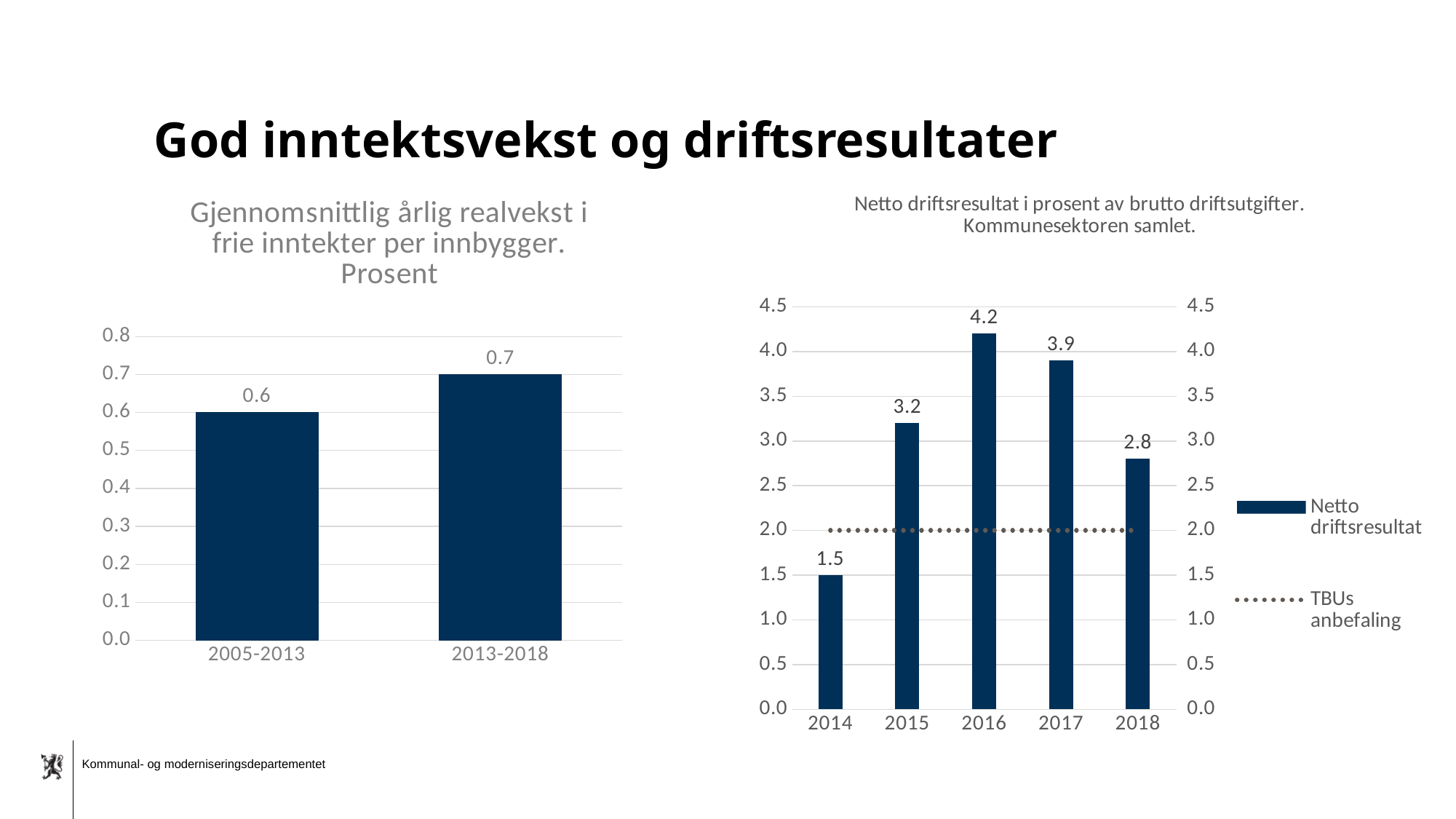
In the right chart (Netto driftsresultat i prosent av brutto driftsutgifter), what is the difference between the 2017 and 2018 values? 1.1 In the left chart (Gjennomsnittlig årlig realvekst i frie inntekter per innbygger), how many categories are shown? 2 In the right chart (Netto driftsresultat i prosent av brutto driftsutgifter), which is larger, the value for 2015 or the value for 2018? 2015 In the right chart (Netto driftsresultat i prosent av brutto driftsutgifter), which year has the highest Netto driftsresultat? 2016 In the right chart (Netto driftsresultat i prosent av brutto driftsutgifter), which year has the lowest Netto driftsresultat? 2014 In the right chart (Netto driftsresultat i prosent av brutto driftsutgifter), how many entries does the legend list? 2 In the right chart (Netto driftsresultat i prosent av brutto driftsutgifter), what is the value for 2014? 1.5 In the right chart (Netto driftsresultat i prosent av brutto driftsutgifter), what value does the dotted TBUs anbefaling line sit at? 2.0 In the left chart (Gjennomsnittlig årlig realvekst i frie inntekter per innbygger), what is the value for 2005-2013? 0.6 In the left chart (Gjennomsnittlig årlig realvekst i frie inntekter per innbygger), what is the value for 2013-2018? 0.7 In the left chart (Gjennomsnittlig årlig realvekst i frie inntekter per innbygger), what is the difference between the 2013-2018 and 2005-2013 values? 0.1 In the right chart (Netto driftsresultat i prosent av brutto driftsutgifter), what is the value for 2016? 4.2